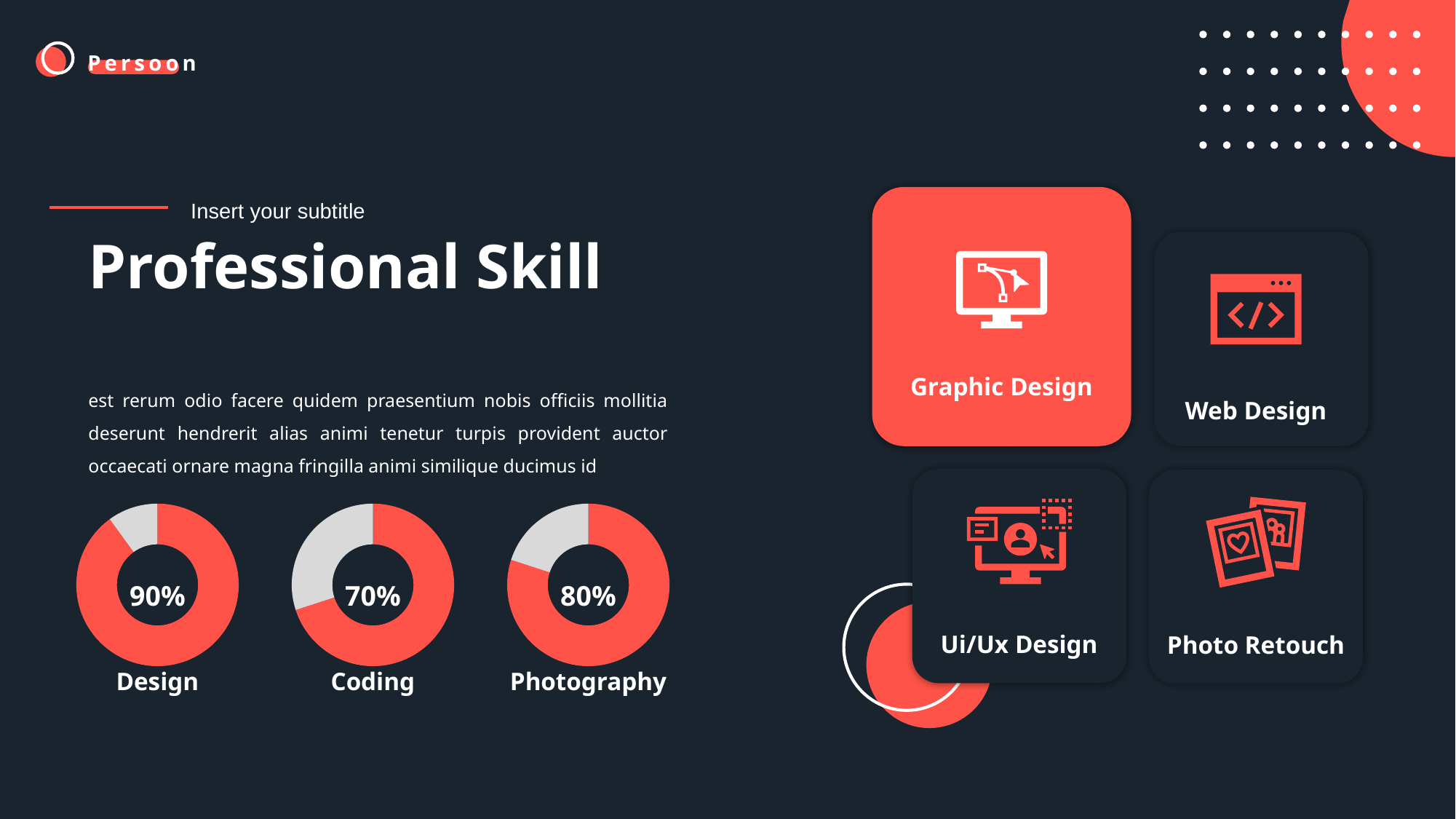
What is the difference between the Design and Coding percentages? 20% What kind of chart is used to show the skill percentages? Donut chart What value is shown in the Coding donut chart? 70% Which of the three donut charts shows the lowest percentage? Coding How many donut charts are shown on the slide? 3 What colour is the filled portion of each donut chart? Red Which of the three donut charts shows the highest percentage? Design What value is shown in the Photography donut chart? 80% What value is shown in the Design donut chart? 90% What is the difference between the Photography and Coding percentages? 10% Which is larger, the Photography value or the Coding value? Photography Which is larger, the Design value or the Photography value? Design